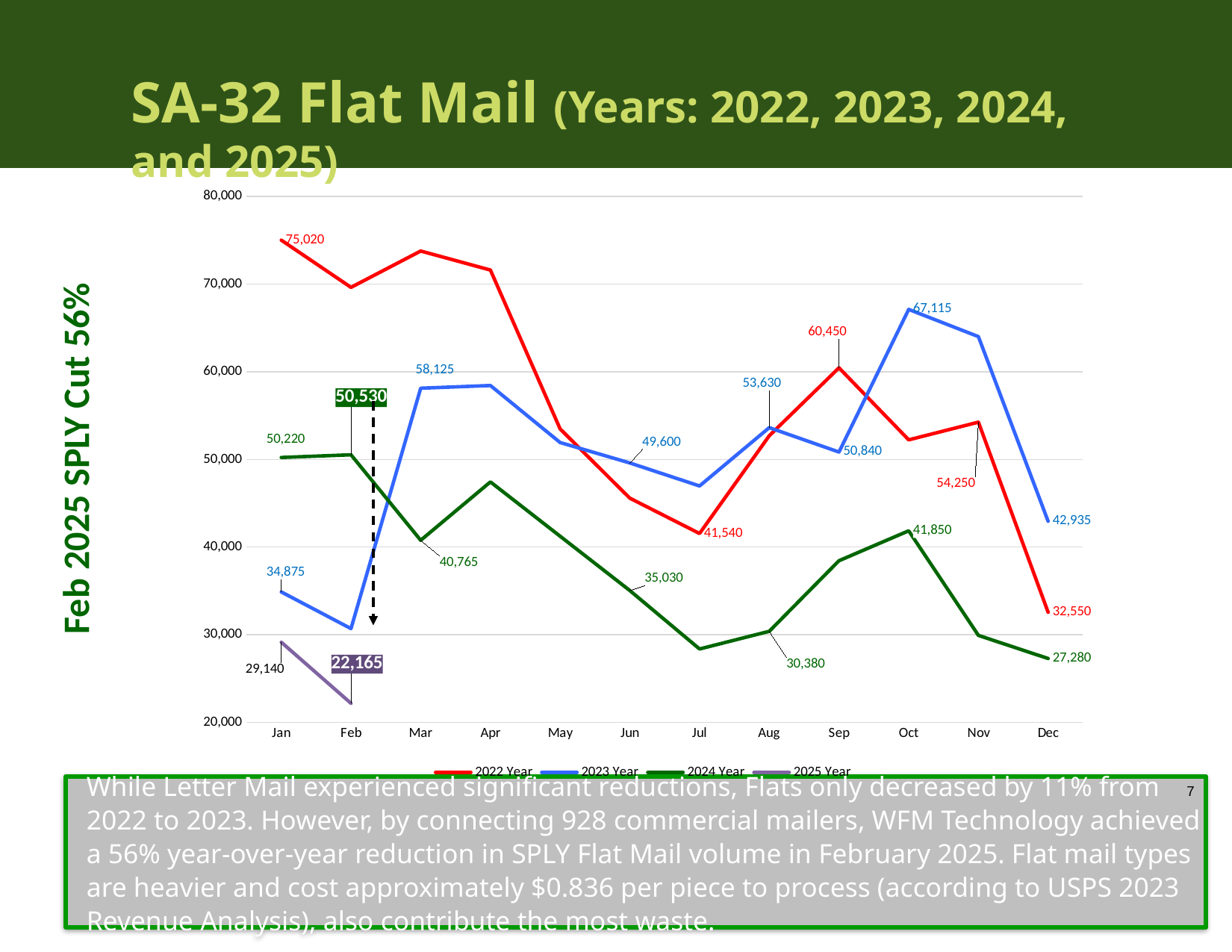
What is the difference between the Feb values of the 2024 Year and 2025 Year series? 28,365 How many series does the chart legend list? 4 What is the value for the 2022 Year series in Jan? 75,020 What kind of chart is shown on the slide? Line chart In which month is the 2023 Year series at its lowest? Feb What is the value for the 2024 Year series in Dec? 27,280 What is the value for the 2023 Year series in Oct? 67,115 In Dec, which series has the larger value: 2022 Year or 2023 Year? 2023 Year Does the 2025 Year series rise or fall from Jan to Feb? Fall How many months are shown along the x axis? 12 Is the value for the 2022 Year series in Mar greater or less than 70,000? greater What is the value for the 2025 Year series in Feb? 22,165